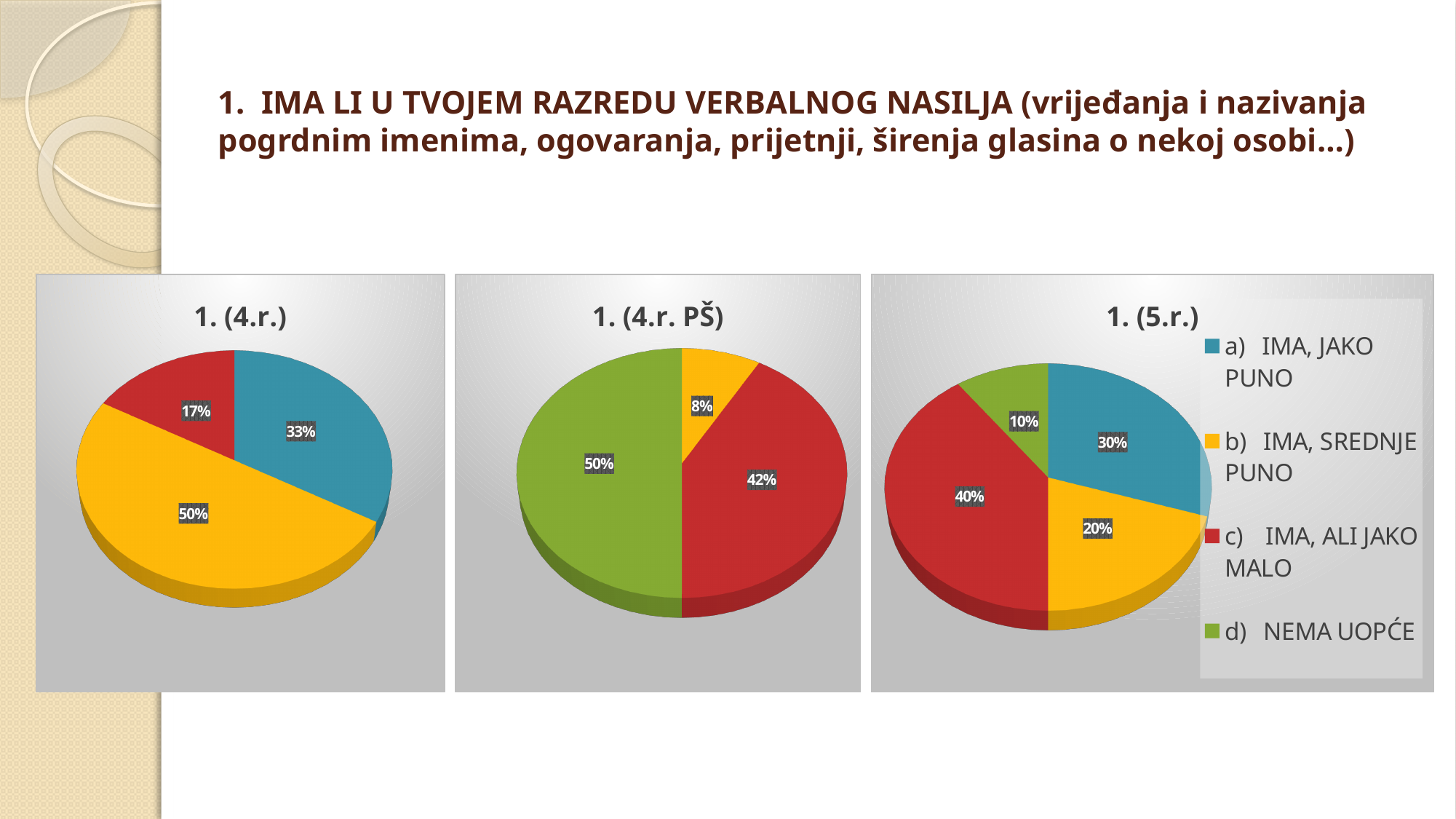
In the chart titled "1. (4.r.)", which category has the smallest slice? c) IMA, ALI JAKO MALO In the chart titled "1. (5.r.)", which category has the smallest slice? d) NEMA UOPĆE In the chart titled "1. (5.r.)", what share is shown for "c) IMA, ALI JAKO MALO"? 40% How many slices does the chart titled "1. (4.r. PŠ)" have? 3 In the chart titled "1. (4.r. PŠ)", what share is shown for "c) IMA, ALI JAKO MALO"? 42% In the chart titled "1. (5.r.)", what share is shown for "d) NEMA UOPĆE"? 10% In the chart titled "1. (4.r.)", what share is shown for "b) IMA, SREDNJE PUNO"? 50% In the chart titled "1. (5.r.)", which is larger: the share for "a) IMA, JAKO PUNO" or the share for "b) IMA, SREDNJE PUNO"? a) IMA, JAKO PUNO What kind of chart is the chart titled "1. (5.r.)"? Pie chart How many entries does the legend on the slide list? 4 In the chart titled "1. (4.r. PŠ)", which category has the largest slice? d) NEMA UOPĆE In the chart titled "1. (4.r.)", what is the difference between the shares for "b) IMA, SREDNJE PUNO" and "a) IMA, JAKO PUNO"? 17%